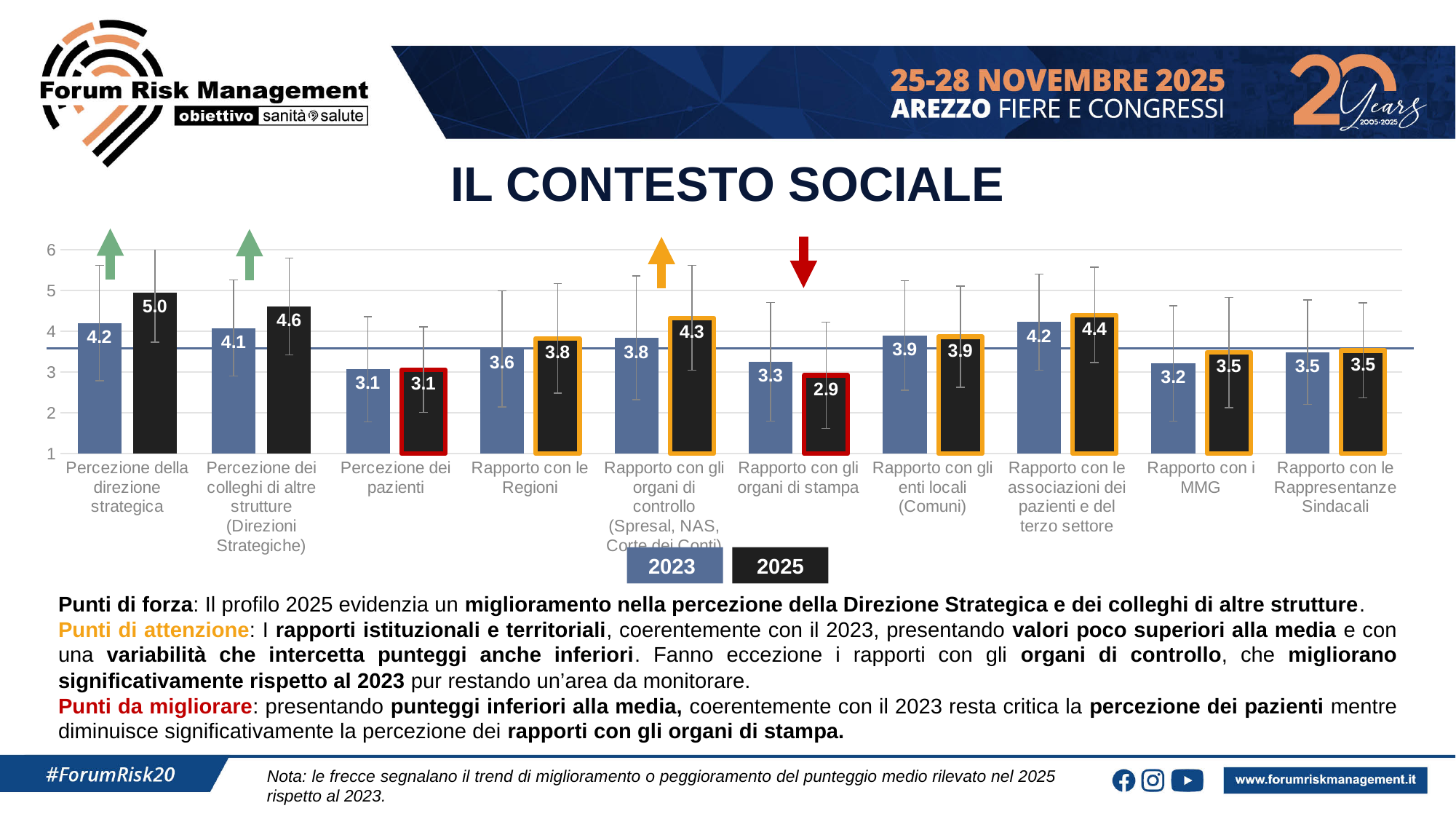
What is the 2025 value for 'Rapporto con gli organi di controllo (Spresal, NAS, Corte dei Conti)'? 4.3 Which series is shown in black in the legend? 2025 Which category has the lowest 2025 value? Rapporto con gli organi di stampa What is the 2025 value for 'Percezione della direzione strategica'? 5.0 Which category has the highest 2025 value? Percezione della direzione strategica What type of chart is shown on the slide? bar chart What is the difference between the 2025 and 2023 values for 'Percezione dei colleghi di altre strutture (Direzioni Strategiche)'? 0.5 Which is larger for 'Rapporto con gli organi di stampa': the 2023 value or the 2025 value? 2023 How many series does the legend list? 2 How many categories are shown on the x axis of the chart? 10 What is the 2023 value for 'Rapporto con gli organi di stampa'? 3.3 Which category has the lowest 2023 value? Percezione dei pazienti